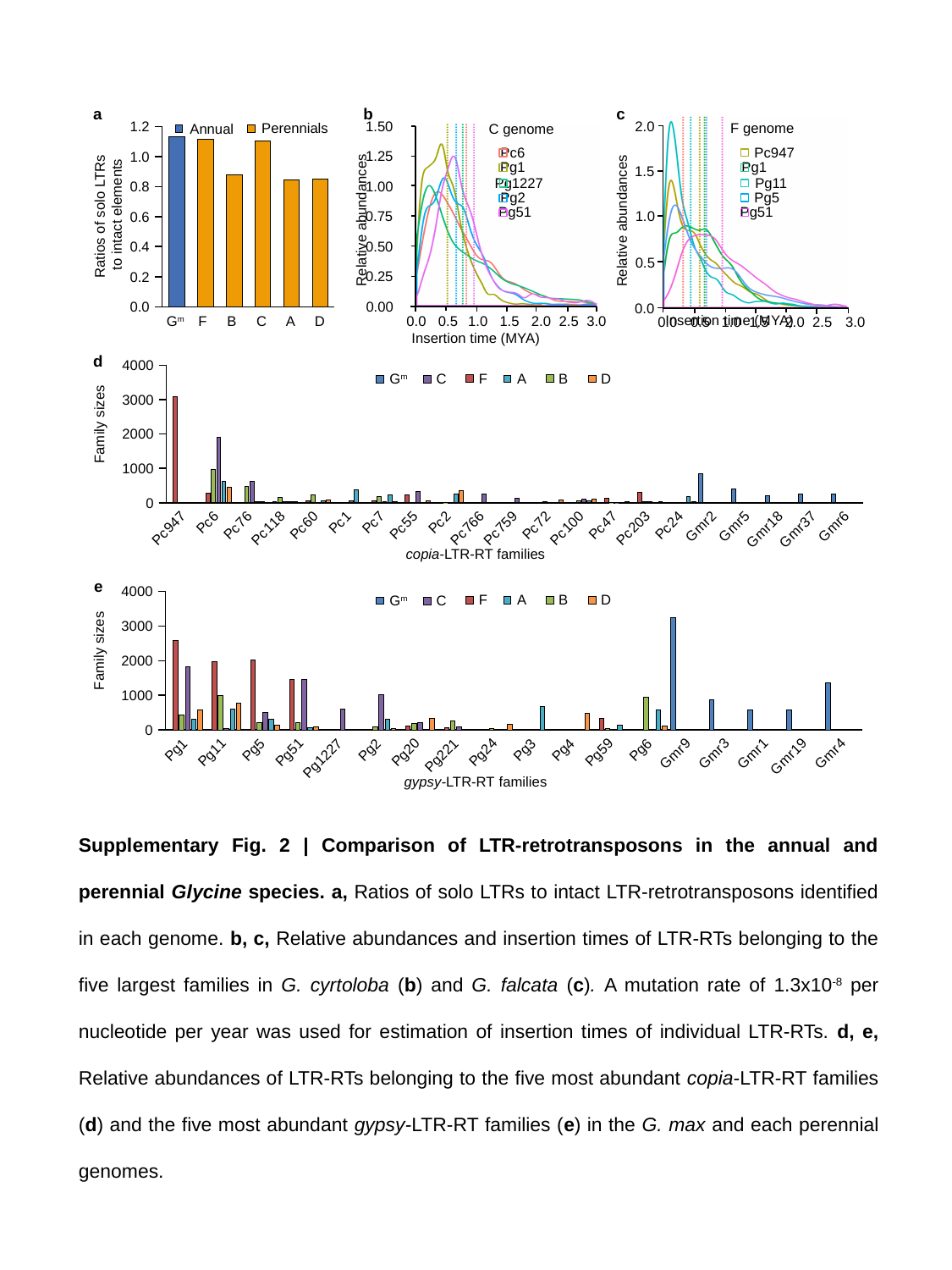
In chart a, which is larger, the value for F or the value for A? F In chart a, is the value for B greater or less than 1.0? less In chart e (gypsy-LTR-RT families), is the Gm value for Gmr9 greater or less than 3000? greater In chart e (gypsy-LTR-RT families), how many families are shown on the x axis? 18 In chart c (F genome), how many families does the legend list? 5 In chart a, how many series does the legend list? 2 In chart a (Ratios of solo LTRs to intact elements), how many genomes are shown on the x axis? 6 In chart d (copia-LTR-RT families), how many series does the legend list? 6 In chart b (C genome), what is the label of the x axis? Insertion time (MYA) In chart a, is the value for Gm greater or less than 1.0? greater What kind of chart is chart b (C genome)? line chart In chart d (copia-LTR-RT families), which family has the tallest bar? Pc947